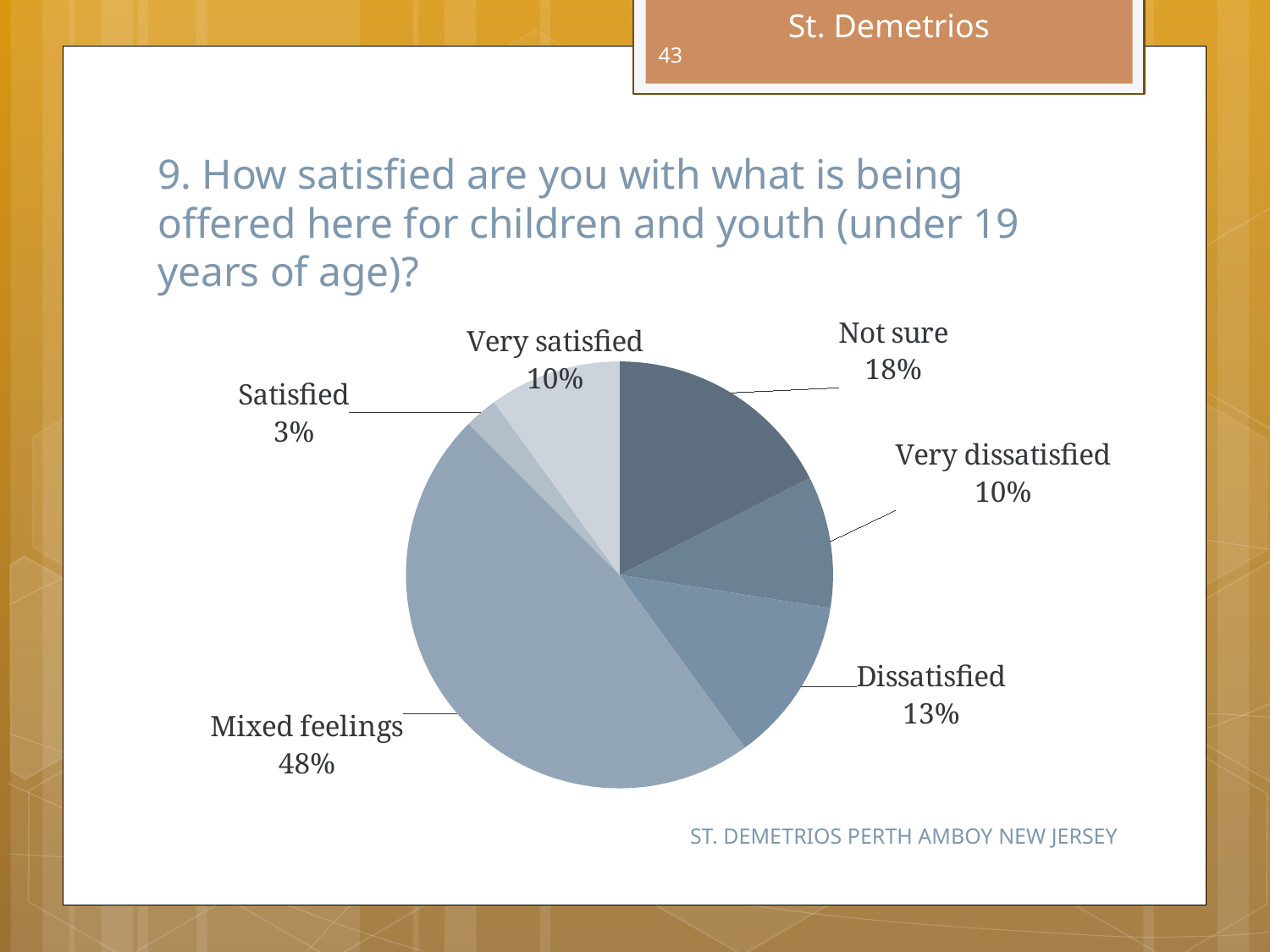
What is the difference in percentage points between "Mixed feelings" and "Not sure"? 30 What percentage of respondents answered "Not sure"? 18% What percentage of respondents answered "Mixed feelings"? 48% Which response has the smallest share of the pie? Satisfied What kind of chart is shown on the slide? Pie chart What survey question does the chart on the slide illustrate? 9. How satisfied are you with what is being offered here for children and youth (under 19 years of age)? What percentage of respondents answered "Dissatisfied"? 13% How many response categories are shown in the pie chart? 6 What is the combined percentage for "Very satisfied" and "Satisfied"? 13% What percentage of respondents answered "Satisfied"? 3% Which is larger, the share for "Dissatisfied" or the share for "Very dissatisfied"? Dissatisfied Which response has the largest share of the pie? Mixed feelings